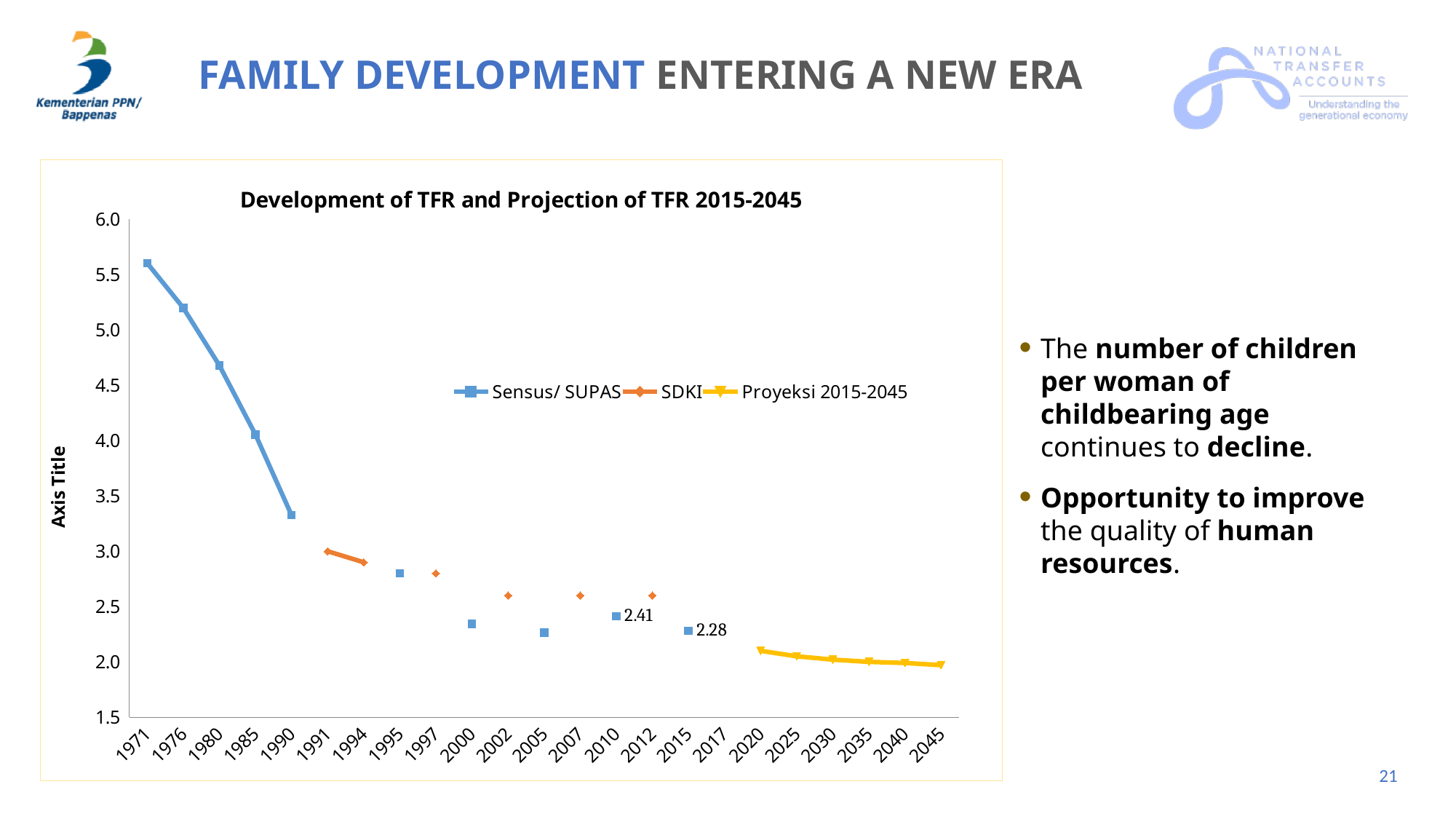
In which year does the chart show its highest value? 1971 Which is larger, the Sensus/ SUPAS value for 2010 or for 2015? 2010 Does the Sensus/ SUPAS series rise or fall from 1971 to 1990? Fall What is the title of the chart? Development of TFR and Projection of TFR 2015-2045 Is the Sensus/ SUPAS value for 1990 greater or less than 3.5? less What is the Sensus/ SUPAS value labelled for 2010? 2.41 What kind of chart is shown on the slide? Line chart Is the Sensus/ SUPAS value for 1971 greater or less than 5.0? greater What is the difference between the labelled Sensus/ SUPAS values for 2010 and 2015? 0.13 What is the Sensus/ SUPAS value labelled for 2015? 2.28 Is the Proyeksi 2015-2045 value for 2045 greater or less than 2.5? less How many series does the chart's legend list? 3